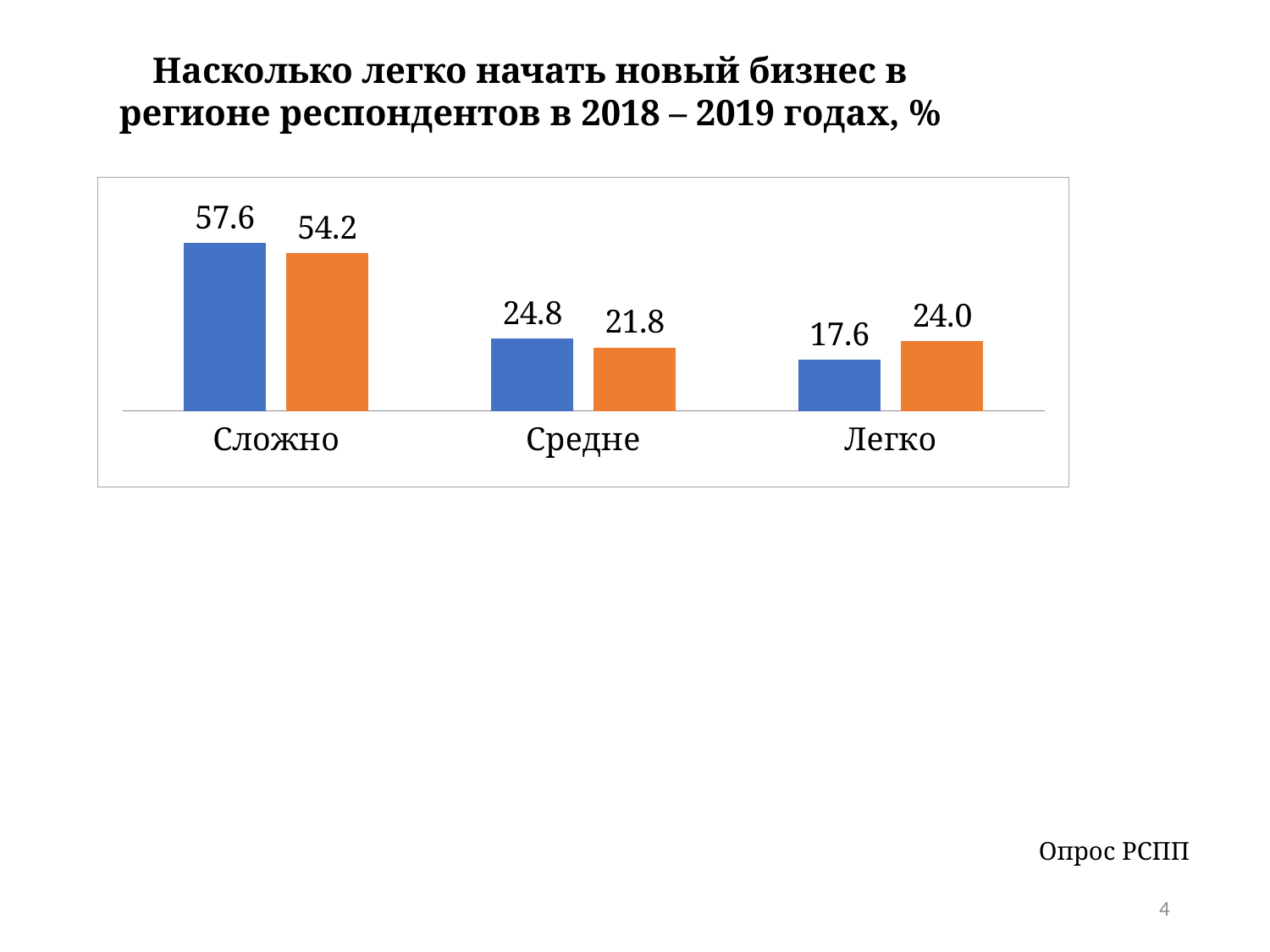
What is the value of the blue bar for Средне? 24.8 For Легко, which bar is larger, the blue or the orange one? orange Which category has the highest blue bar? Сложно What is the difference between the orange and blue bars for Легко? 6.4 What is the value of the orange bar for Сложно? 54.2 What kind of chart is shown on the slide? bar chart What is the difference between the blue and orange bars for Сложно? 3.4 What is the value of the orange bar for Легко? 24.0 Which category has the lowest orange bar? Средне What is the value of the blue bar for Сложно? 57.6 How many categories are shown on the x axis? 3 Do the blue bars rise or fall from Сложно to Легко? fall